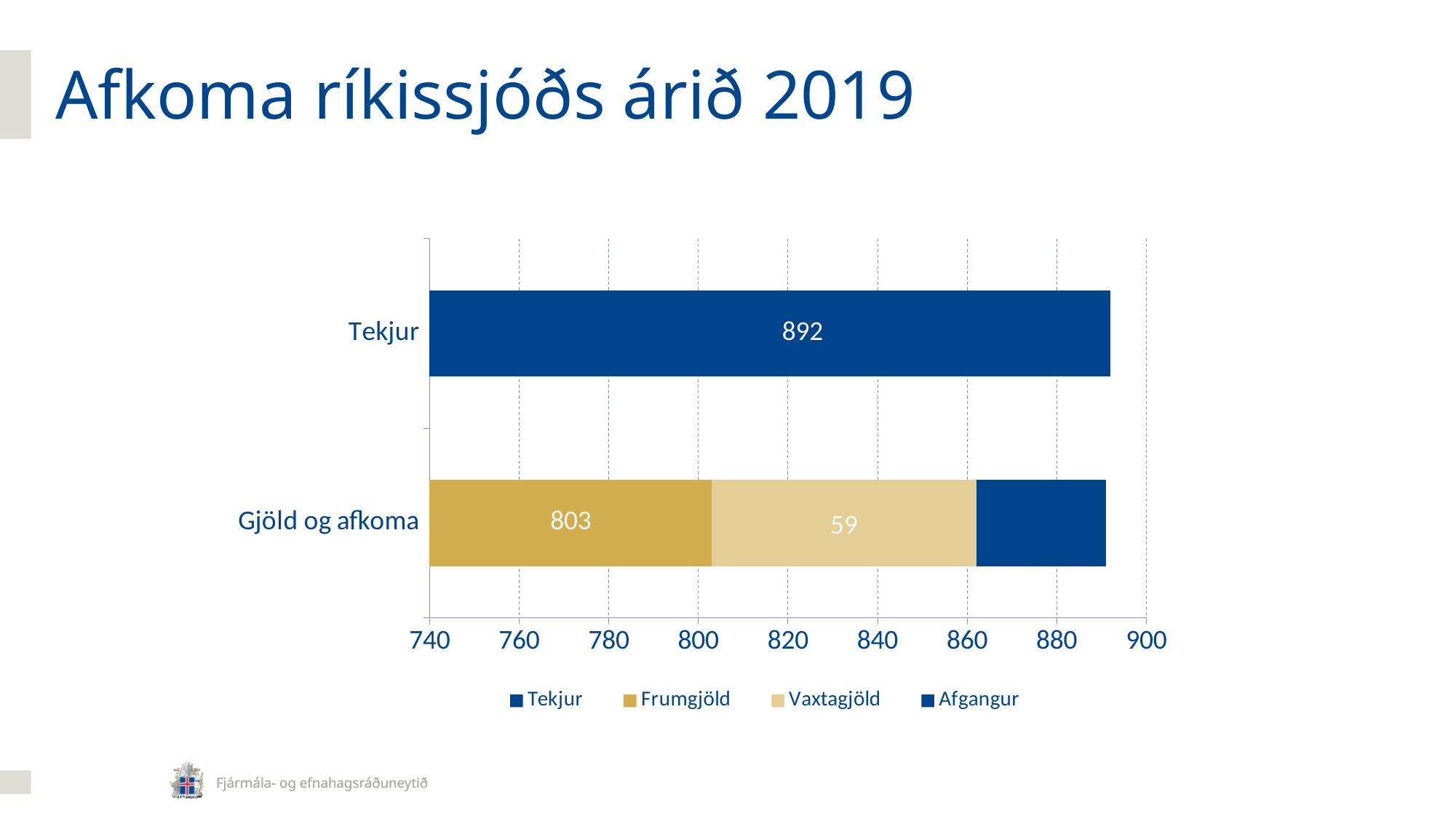
What kind of chart is shown on the slide? Stacked bar chart How many series does the legend list? 4 How many categories are shown on the vertical axis of the chart? 2 Is the Frumgjöld value greater or less than 820? less Is the value for Tekjur greater or less than 880? greater What is the value of the Vaxtagjöld segment in the Gjöld og afkoma bar? 59 Which legend entry is shown in the lightest colour? Vaxtagjöld What is the value of the Tekjur bar? 892 What is the difference between the Tekjur value and the Frumgjöld value? 89 Which is larger, the Frumgjöld segment or the Vaxtagjöld segment? Frumgjöld What is the title of the slide containing the chart? Afkoma ríkissjóðs árið 2019 What is the value of the Frumgjöld segment in the Gjöld og afkoma bar? 803